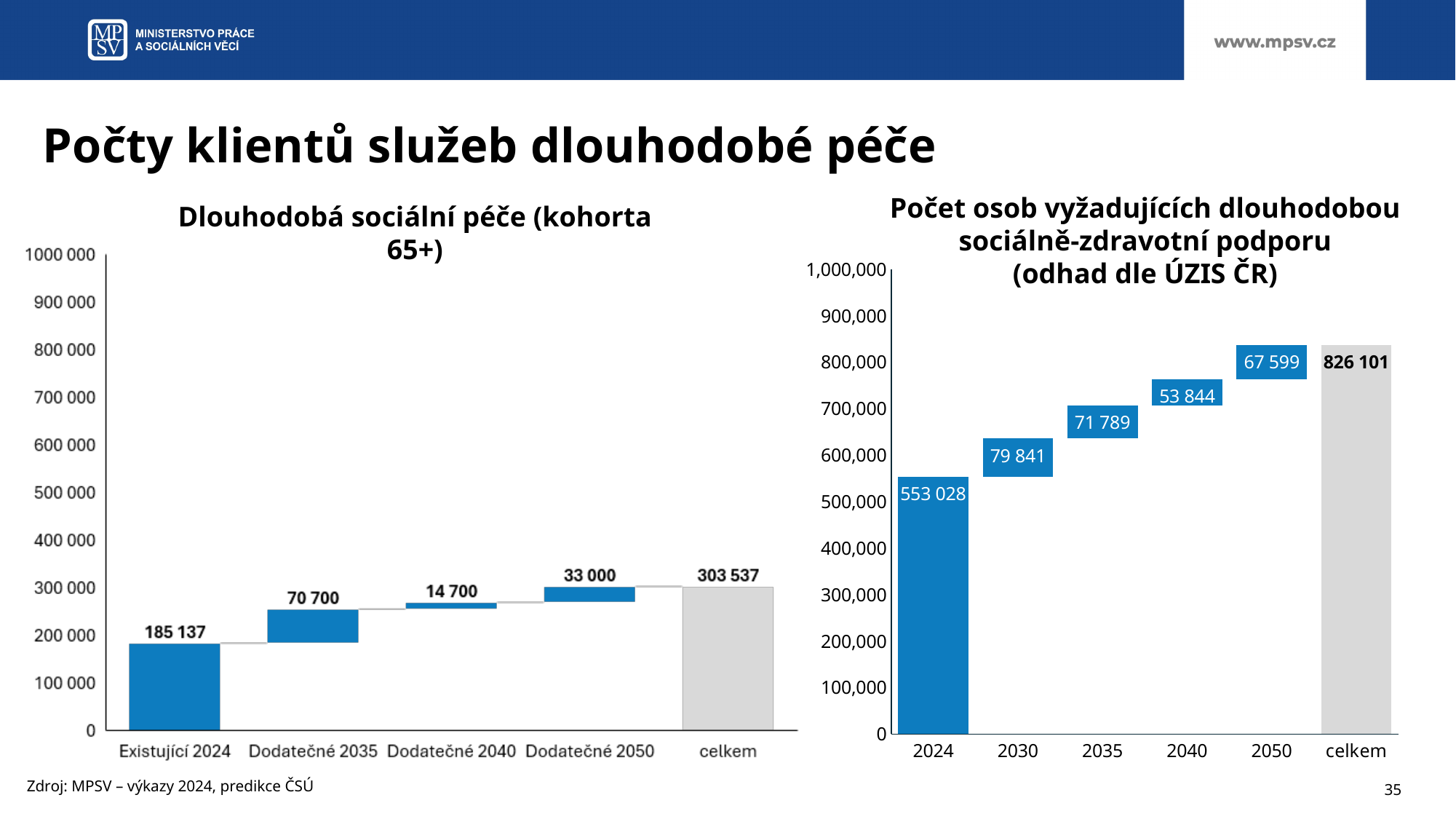
In the left chart (Dlouhodobá sociální péče, kohorta 65+), what is the difference between Dodatečné 2035 and Dodatečné 2050? 37 700 In the left chart (Dlouhodobá sociální péče, kohorta 65+), how many categories are shown on the x axis? 5 In the right chart (Počet osob vyžadujících dlouhodobou sociálně-zdravotní podporu), what is the value shown for celkem? 826 101 In the right chart (Počet osob vyžadujících dlouhodobou sociálně-zdravotní podporu), what is the difference between the 2035 and 2040 increments? 17 945 In the left chart (Dlouhodobá sociální péče, kohorta 65+), what is the value shown for celkem? 303 537 What kind of chart is the right chart (Počet osob vyžadujících dlouhodobou sociálně-zdravotní podporu)? Bar chart (waterfall) In the right chart (Počet osob vyžadujících dlouhodobou sociálně-zdravotní podporu), what is the value for 2024? 553 028 In the left chart (Dlouhodobá sociální péče, kohorta 65+), what is the value for Dodatečné 2040? 14 700 In the left chart (Dlouhodobá sociální péče, kohorta 65+), which of the Dodatečné increments is the smallest? Dodatečné 2040 In the left chart (Dlouhodobá sociální péče, kohorta 65+), what is the value for Existující 2024? 185 137 In the right chart (Počet osob vyžadujících dlouhodobou sociálně-zdravotní podporu), which is larger, the increment for 2030 or for 2050? 2030 In the right chart (Počet osob vyžadujících dlouhodobou sociálně-zdravotní podporu), what is the value for 2040? 53 844